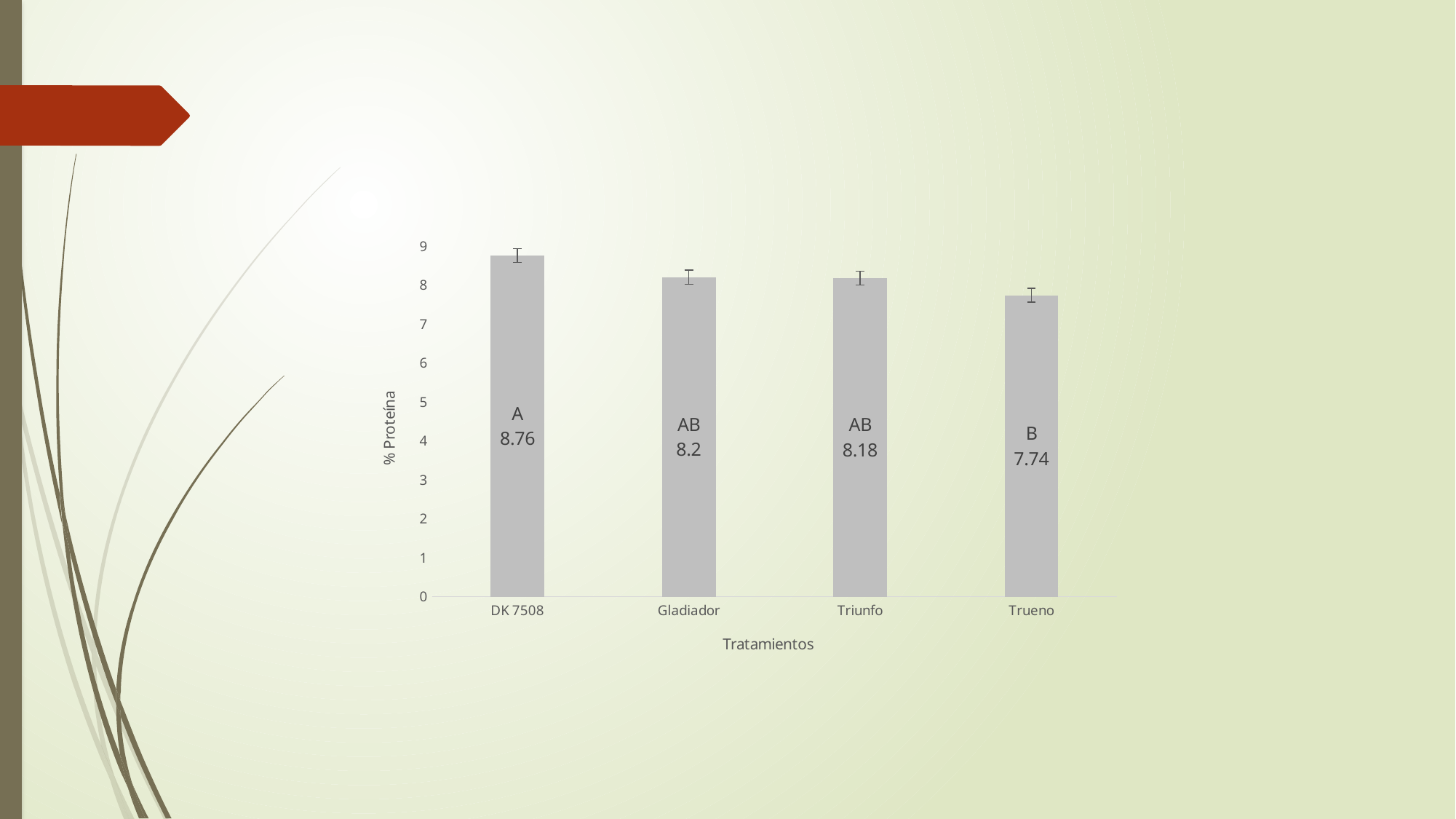
Which has a higher % Proteína, DK 7508 or Triunfo? DK 7508 What is the label of the x axis? Tratamientos What is the % Proteína value for DK 7508? 8.76 Which treatment has the highest % Proteína? DK 7508 How many treatments are shown on the x axis? 4 Which treatment has the lowest % Proteína? Trueno What is the difference in % Proteína between DK 7508 and Trueno? 1.02 Is the value for Trueno greater or less than 8? less What is the difference in % Proteína between Gladiador and Triunfo? 0.02 What is the % Proteína value for Gladiador? 8.2 What is the % Proteína value for Trueno? 7.74 What kind of chart is shown on the slide? bar chart